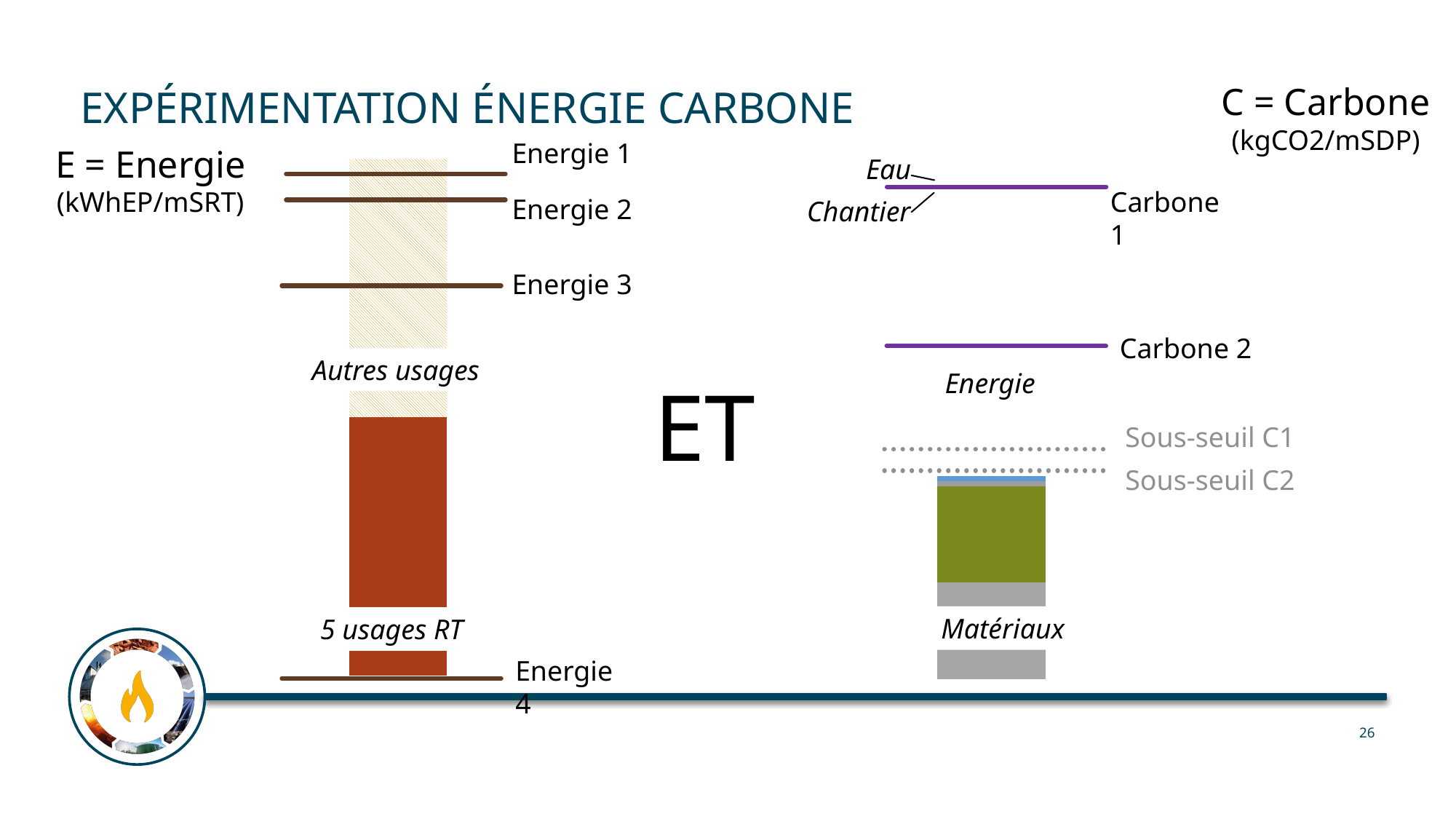
What unit is given for C = Carbone on the right chart? kgCO2/mSDP On the right chart, which threshold line is higher, Carbone 1 or Carbone 2? Carbone 1 How many 'Energie' threshold lines are labelled on the left chart? 4 On the left chart, which labelled threshold line is the highest? Energie 1 How many dotted 'Sous-seuil' lines are shown on the right chart? 2 On the right chart, how many labelled components make up the stacked bar? 4 What unit is given for E = Energie on the left chart? kWhEP/mSRT On the left chart, which threshold line is higher, Energie 2 or Energie 3? Energie 2 On the left chart, which labelled threshold line is the lowest? Energie 4 What kind of chart is shown on the left (Energie) side of the slide? stacked bar chart